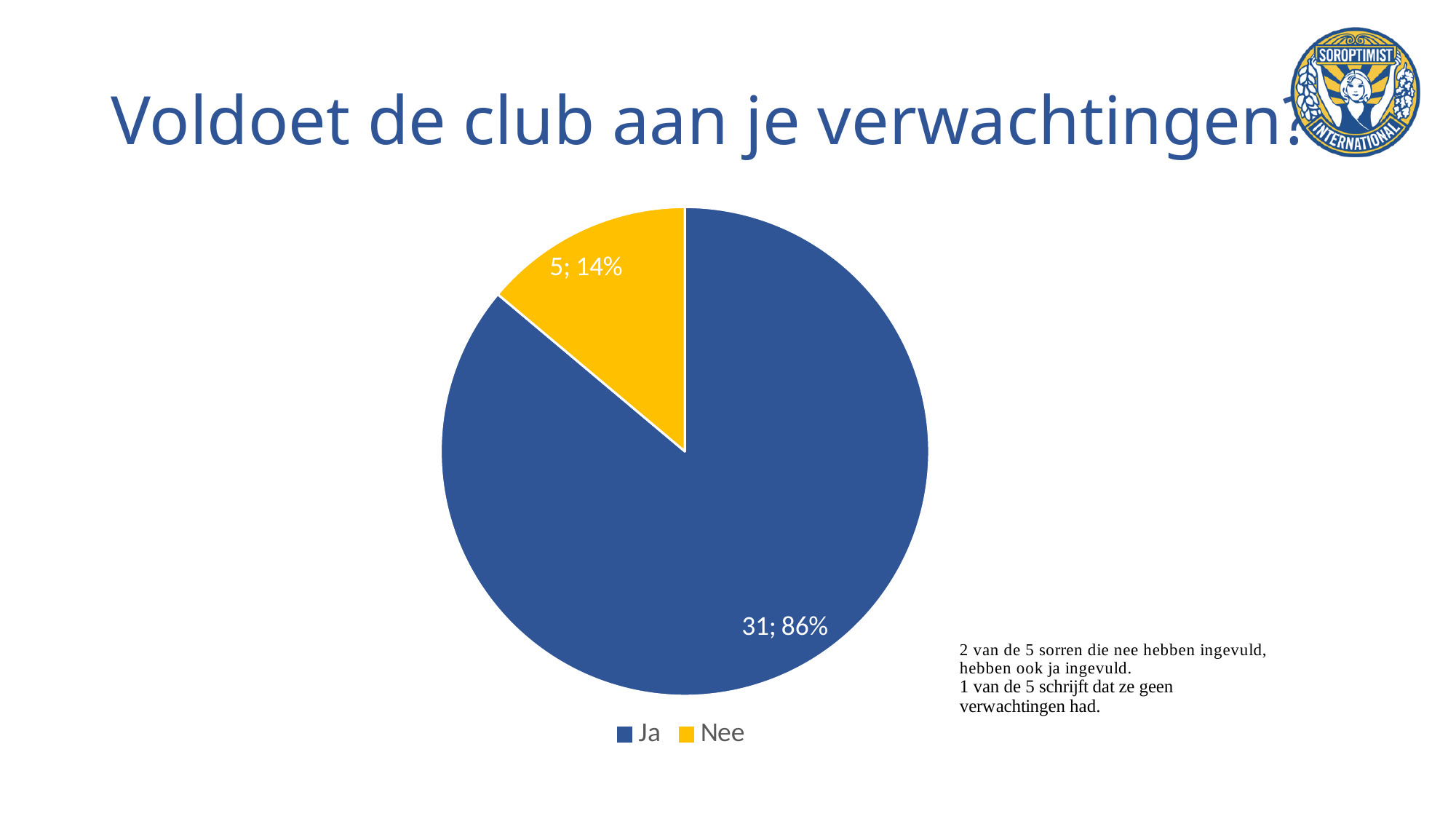
What is the total number of responses shown in the pie chart? 36 What colour is the "Nee" slice? yellow Which category has the smallest slice of the pie? Nee What percentage of the pie does the "Nee" slice represent? 14% What kind of chart is shown on the slide? pie chart What percentage of the pie does the "Ja" slice represent? 86% Which is larger, the "Ja" slice or the "Nee" slice? Ja Which category has the largest slice of the pie? Ja What is the difference between the number of "Ja" and "Nee" responses? 26 How many respondents answered "Nee"? 5 How many respondents answered "Ja"? 31 How many categories does the pie chart have? 2